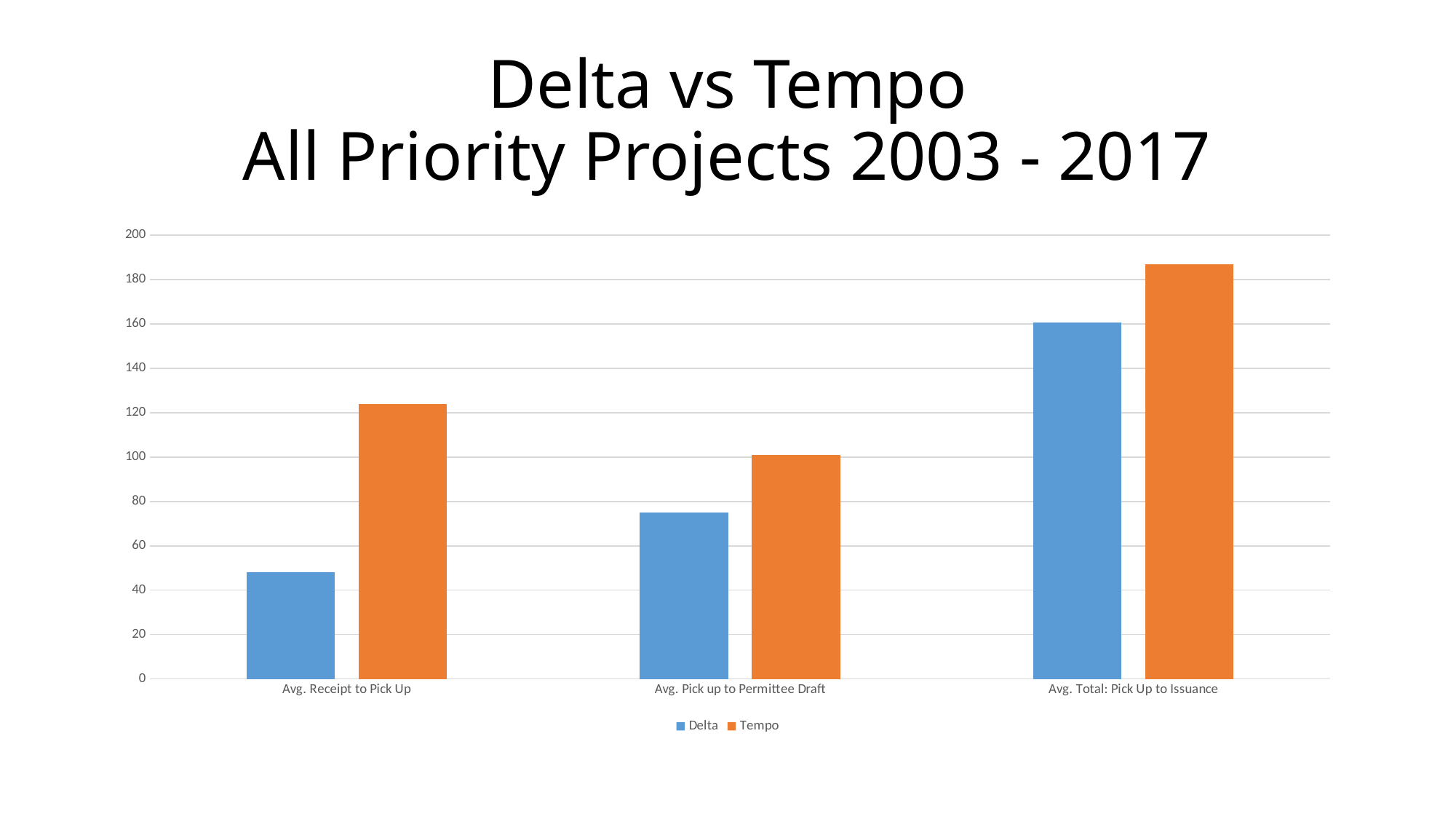
Which series has the higher value for Avg. Total: Pick Up to Issuance, Delta or Tempo? Tempo Which category has the lowest Delta value? Avg. Receipt to Pick Up Which category has the lowest Tempo value? Avg. Pick up to Permittee Draft Is the Delta value for Avg. Receipt to Pick Up greater or less than 60? less Is the Tempo value for Avg. Receipt to Pick Up greater or less than 100? greater What kind of chart is shown on the slide? bar chart How many categories are shown on the x axis? 3 How many series does the legend list? 2 Which category has the highest Delta value? Avg. Total: Pick Up to Issuance Which series has the higher value for Avg. Receipt to Pick Up, Delta or Tempo? Tempo What is the title of the chart on the slide? Delta vs Tempo All Priority Projects 2003 - 2017 Is the Delta value for Avg. Total: Pick Up to Issuance greater or less than 140? greater